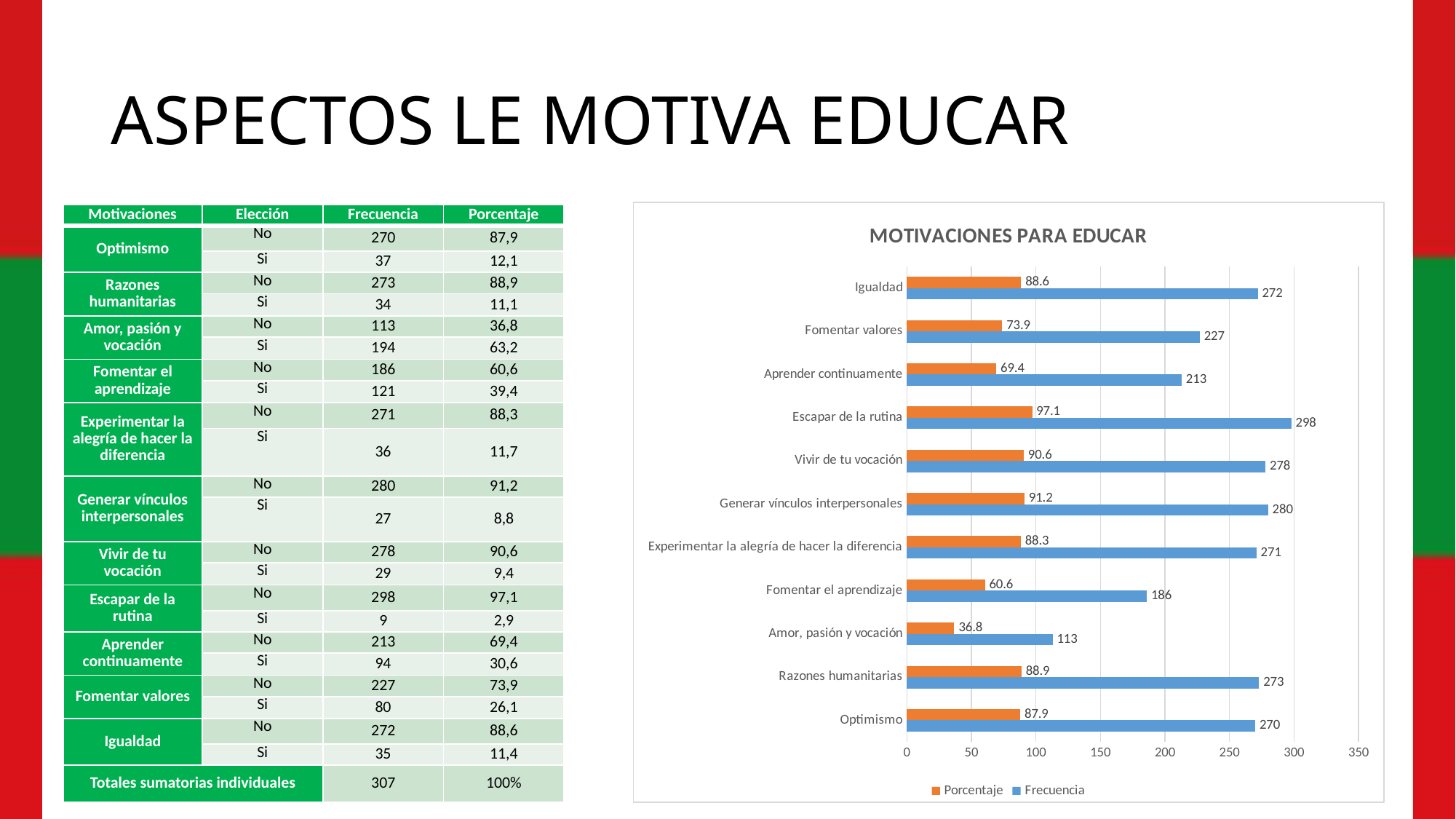
What is the difference between the Frecuencia values for Igualdad and Fomentar valores? 45 What is the Porcentaje value for Fomentar valores? 73.9 How many series does the chart legend list? 2 How many categories are shown on the chart? 11 Which has a larger Frecuencia value, Aprender continuamente or Fomentar el aprendizaje? Aprender continuamente What is the title of the chart? MOTIVACIONES PARA EDUCAR What is the Frecuencia value for Amor, pasión y vocación? 113 What is the Frecuencia value for Escapar de la rutina? 298 Which category has the lowest Porcentaje value? Amor, pasión y vocación Is the Frecuencia value for Generar vínculos interpersonales greater or less than 250? greater What kind of chart is shown on the slide? Bar chart Which category has the highest Frecuencia value? Escapar de la rutina